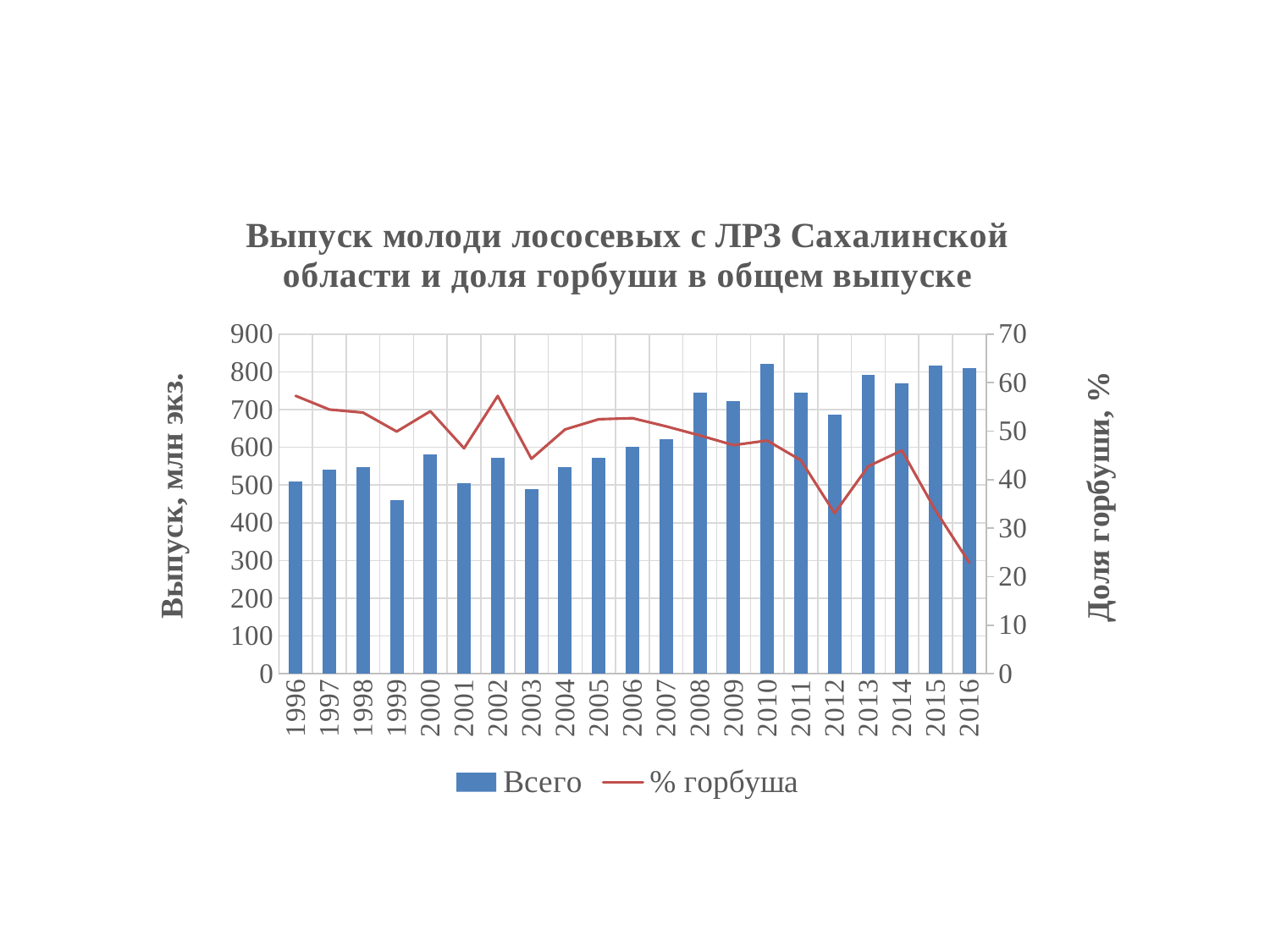
What is the label of the right-hand vertical axis? Доля горбуши, % Is the "Всего" value for 2010 greater or less than 800? greater What kind of chart is shown on the slide? A combined bar and line chart How many years are shown on the x axis of the chart? 21 Which year has the lowest bar for "Всего"? 1999 Is the "% горбуша" value for 2012 greater or less than 40? less Is the "Всего" value for 1999 greater or less than 500? less How many series does the chart legend list? 2 In which year is the "% горбуша" line at its lowest point? 2016 Which year has the larger "Всего" bar, 2008 or 2012? 2008 Does the "% горбуша" line generally rise or fall from 1996 to 2016? fall